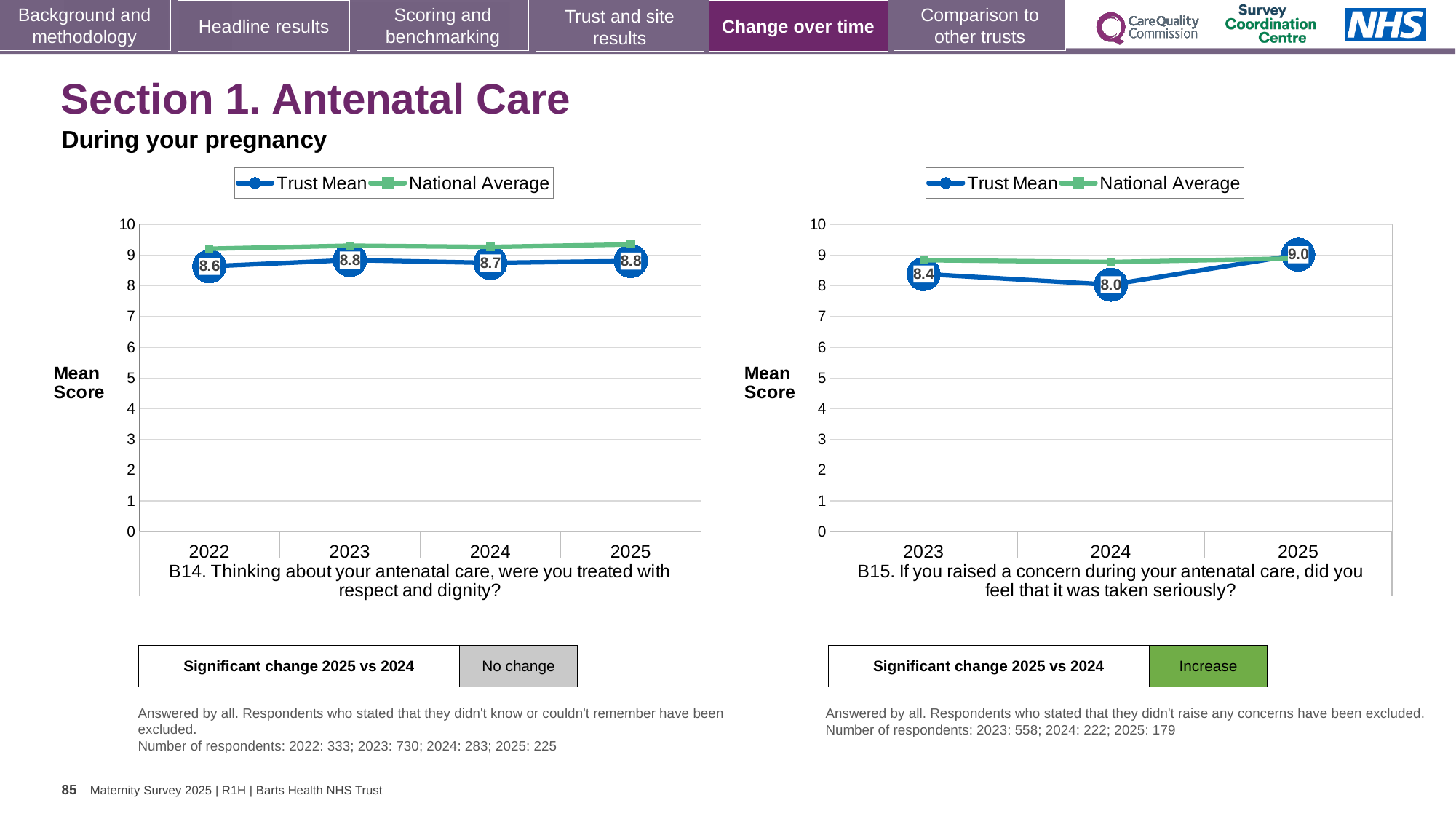
In the left chart (B14), is the National Average for 2022 greater or less than 8? greater In the right chart (B15), what is the difference between the Trust Mean for 2025 and 2024? 1.0 In the left chart (B14), what is the Trust Mean for 2024? 8.7 What kind of chart is the left chart (B14)? Line chart How many years are plotted on the x axis of the right chart (B15)? 3 In the left chart (B14), what is the Trust Mean for 2022? 8.6 In the right chart (B15), what is the Trust Mean for 2025? 9.0 In the left chart (B14), which year has the lowest Trust Mean? 2022 In the right chart (B15), for 2024, which is higher: the Trust Mean or the National Average? National Average In the right chart (B15), what is the Trust Mean for 2024? 8.0 In the right chart (B15), which year has the highest Trust Mean? 2025 How many series does the legend of the left chart (B14) list? 2